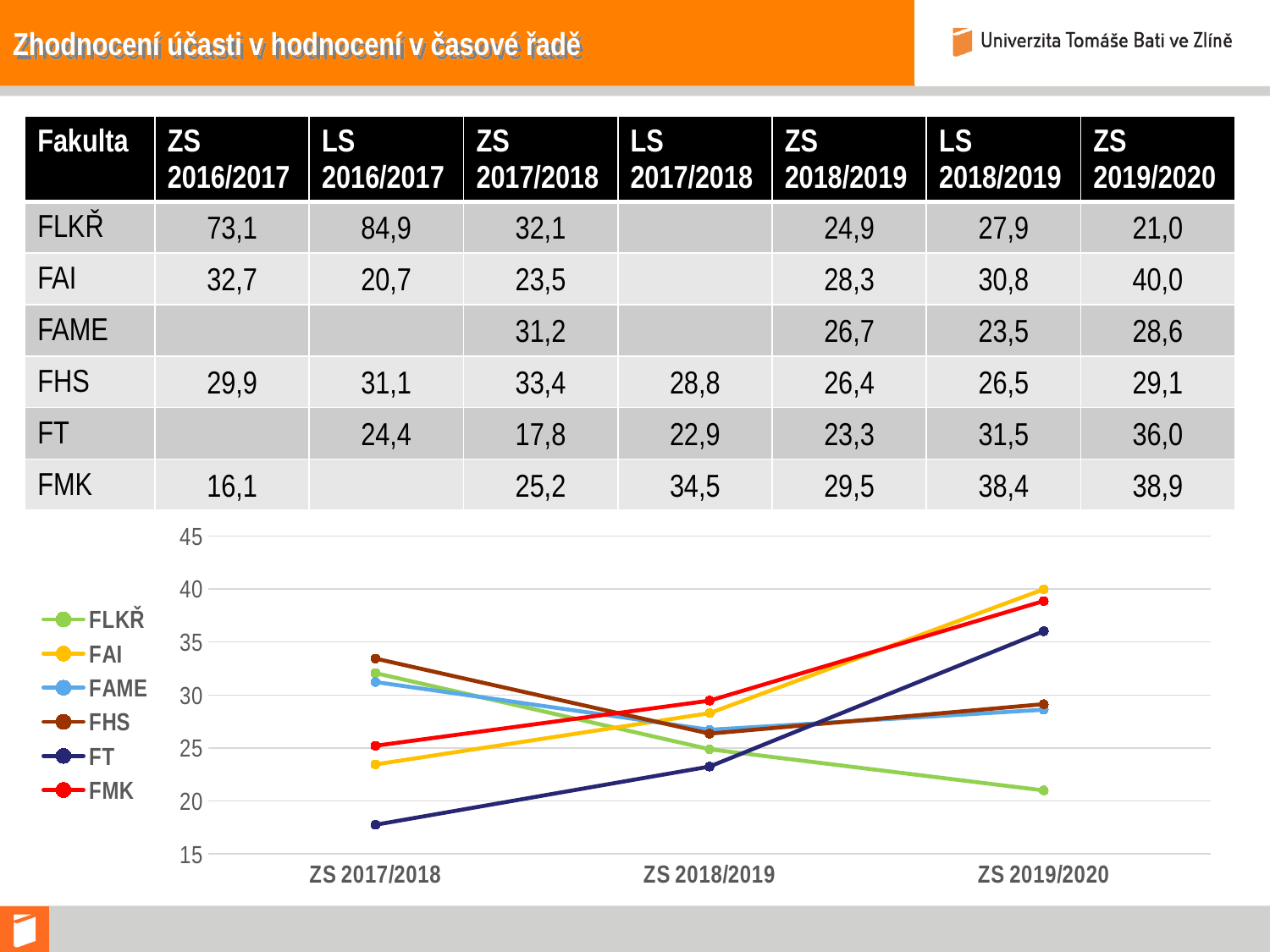
What is the value for FT at ZS 2019/2020? 36,0 Which series has the lowest value at ZS 2017/2018 in the chart? FT Is the value for FMK at ZS 2019/2020 greater or less than 35? greater Does the FT line rise or fall from ZS 2017/2018 to ZS 2019/2020? rise At ZS 2019/2020, which is larger in the chart: FT or FLKŘ? FT Which series has the highest value at ZS 2019/2020 in the chart? FAI What kind of chart is shown on the slide? line chart Is the value for FT at ZS 2017/2018 greater or less than 20? less What is the difference between FAI and FLKŘ at ZS 2019/2020? 19,0 How many series does the chart legend list? 6 Does the FLKŘ line rise or fall from ZS 2017/2018 to ZS 2019/2020? fall How many points are on the x axis of the chart? 3